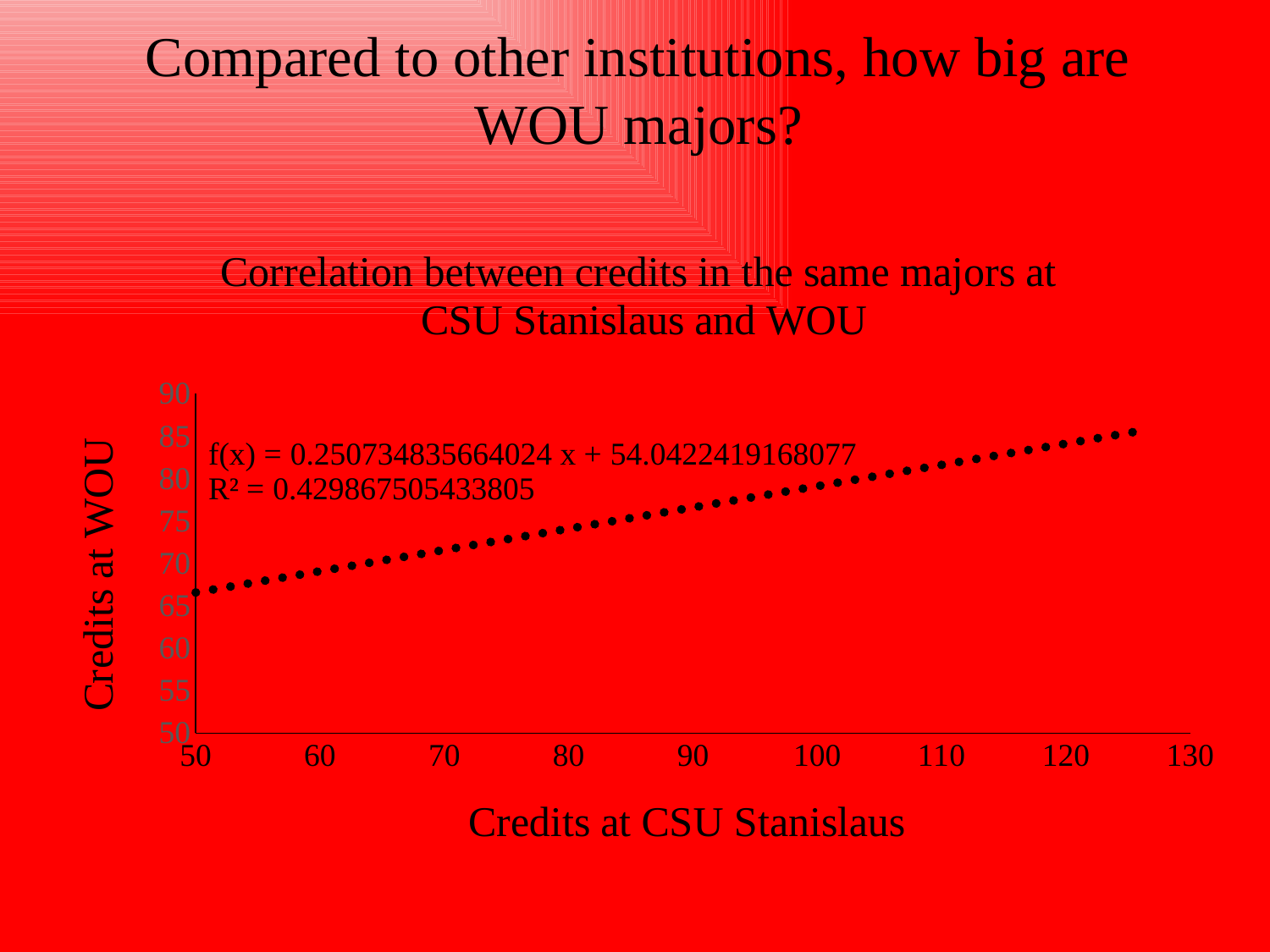
What is the label of the y axis of the chart? Credits at WOU Is the trendline value at 100 Credits at CSU Stanislaus greater or less than 75 Credits at WOU? greater What is the label of the x axis of the chart? Credits at CSU Stanislaus What is the intercept of the trendline shown on the chart? 54.0422419168077 What is the title of the chart on the slide? Correlation between credits in the same majors at CSU Stanislaus and WOU What R² value is shown on the chart? 0.429867505433805 Is the trendline value at 50 Credits at CSU Stanislaus greater or less than 65 Credits at WOU? greater What kind of chart is shown on the slide? Scatter chart with a trendline What is the slope of the trendline shown on the chart? 0.250734835664024 Do the plotted values rise or fall as Credits at CSU Stanislaus increase? Rise What is the trendline equation shown on the chart? f(x) = 0.250734835664024 x + 54.0422419168077 Is the trendline value at 70 Credits at CSU Stanislaus greater or less than 75 Credits at WOU? less